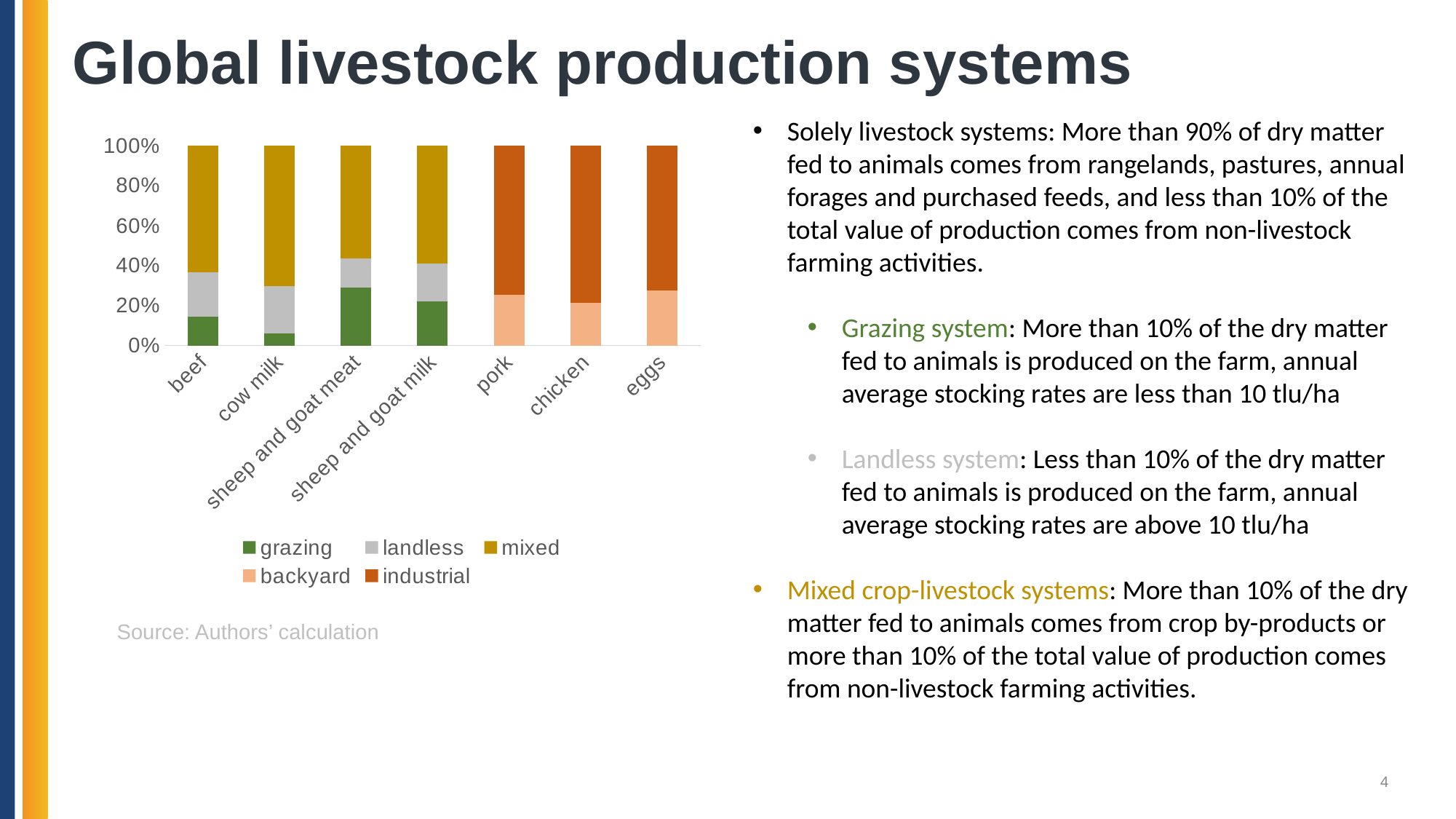
What kind of chart is shown on the slide? stacked bar chart How many categories are shown on the x axis of the chart? 7 Is the industrial share for pork greater or less than 60%? greater Is the grazing share for sheep and goat meat greater or less than 20%? greater Which series are listed in the chart legend? grazing, landless, mixed, backyard, industrial Which category has the smallest grazing share? cow milk Which category has the largest grazing share? sheep and goat meat How many series does the chart legend list? 5 Which has the larger grazing share, beef or cow milk? beef Is the backyard share for eggs greater or less than 40%? less What is the total height of the stacked bar for beef? 100%